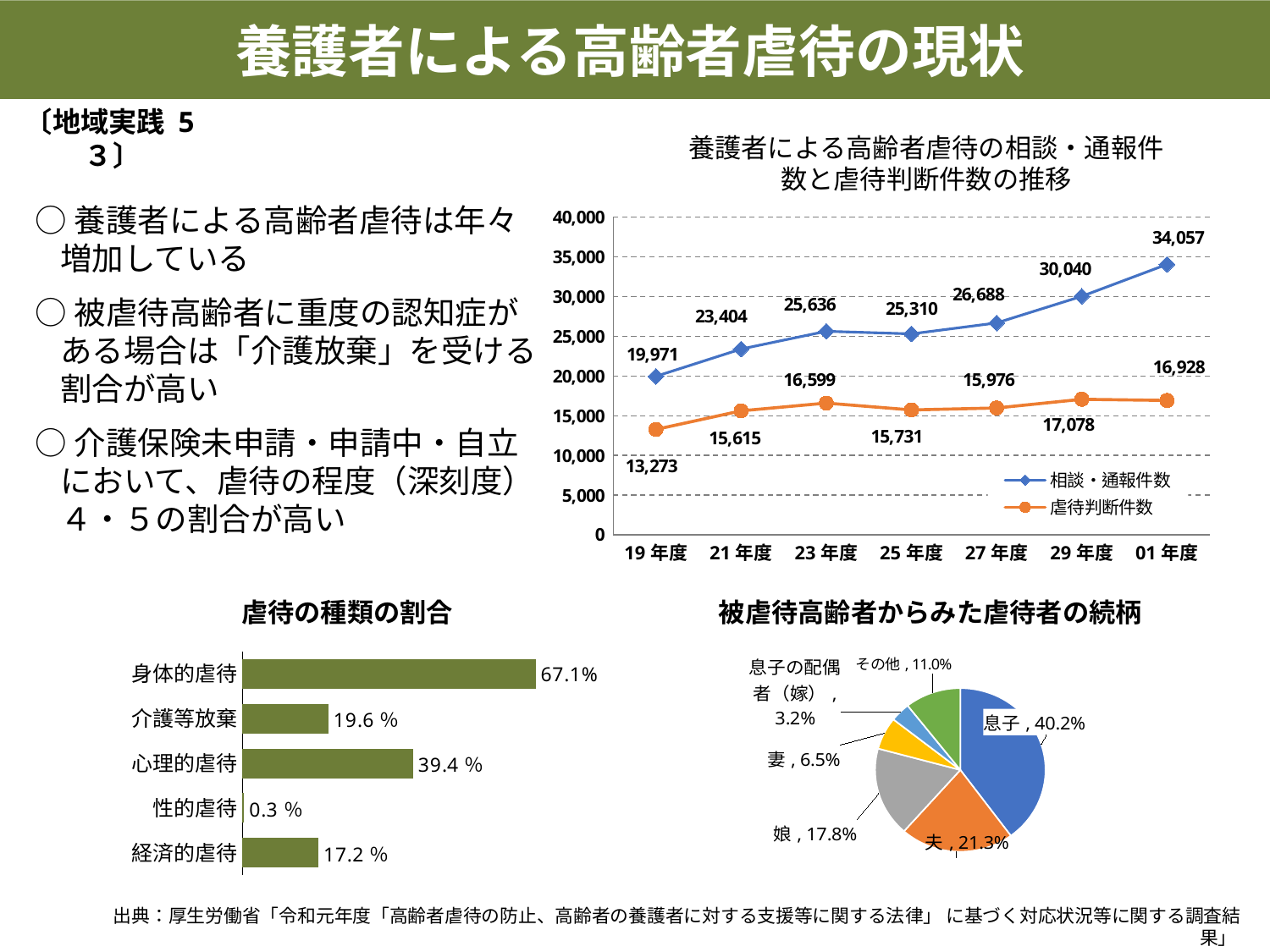
「虐待の種類の割合」のグラフで、最も割合が高い虐待の種類はどれですか？ 身体的虐待 「被虐待高齢者からみた虐待者の続柄」の円グラフで、娘の割合はいくつですか？ 17.8% 「虐待の種類の割合」のグラフには、いくつの虐待の種類が示されていますか？ 5 「虐待の種類の割合」のグラフで、心理的虐待の割合はいくつですか？ 39.4 % 「養護者による高齢者虐待の相談・通報件数と虐待判断件数の推移」のグラフで、29年度と01年度の相談・通報件数の差はいくつですか？ 4,017 「養護者による高齢者虐待の相談・通報件数と虐待判断件数の推移」のグラフで、凡例にはいくつの系列がありますか？ 2 「養護者による高齢者虐待の相談・通報件数と虐待判断件数の推移」のグラフで、01年度の相談・通報件数はいくつですか？ 34,057 「養護者による高齢者虐待の相談・通報件数と虐待判断件数の推移」のグラフで、19年度の虐待判断件数はいくつですか？ 13,273 「虐待の種類の割合」のグラフで、最も割合が低い虐待の種類はどれですか？ 性的虐待 「養護者による高齢者虐待の相談・通報件数と虐待判断件数の推移」のグラフは、どの種類のグラフですか？ 折れ線グラフ 「養護者による高齢者虐待の相談・通報件数と虐待判断件数の推移」のグラフで、相談・通報件数は19年度から01年度にかけて全体として増加していますか、減少していますか？ 増加 「被虐待高齢者からみた虐待者の続柄」の円グラフで、最も大きい割合を占める続柄はどれですか？ 息子